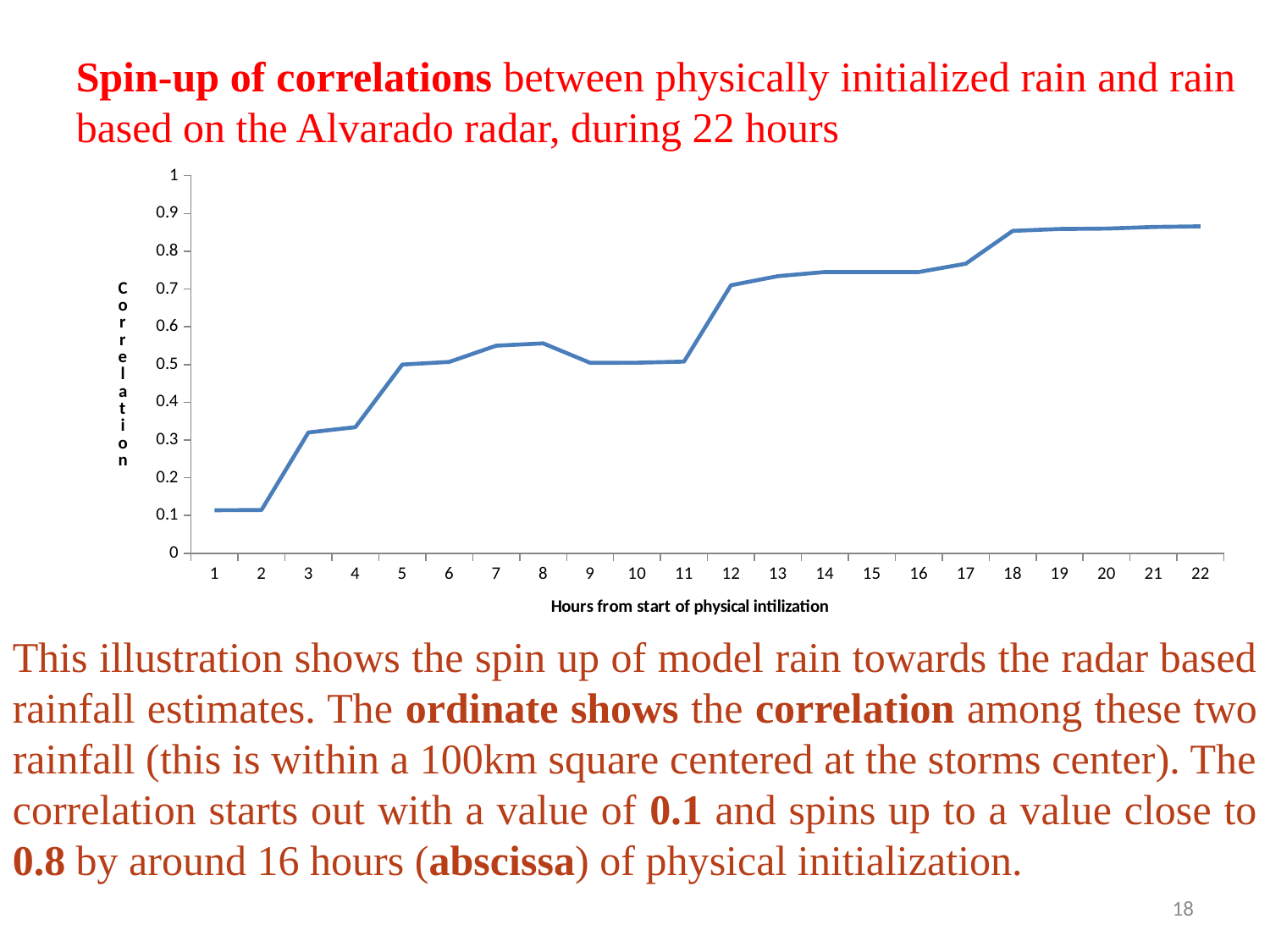
Which has the higher correlation, hour 3 or hour 8? hour 8 Which has the higher correlation, hour 11 or hour 12? hour 12 Do the correlation values generally rise or fall as the hours increase? rise Is the correlation at hour 18 greater or less than 0.8? greater What is the title of the x axis? Hours from start of physical intilization What kind of chart is shown on the slide? line chart What quantity is shown on the y axis? Correlation Is the correlation at hour 16 greater or less than 0.8? less Is the correlation at hour 1 greater or less than 0.2? less How many hourly points are plotted along the x axis? 22